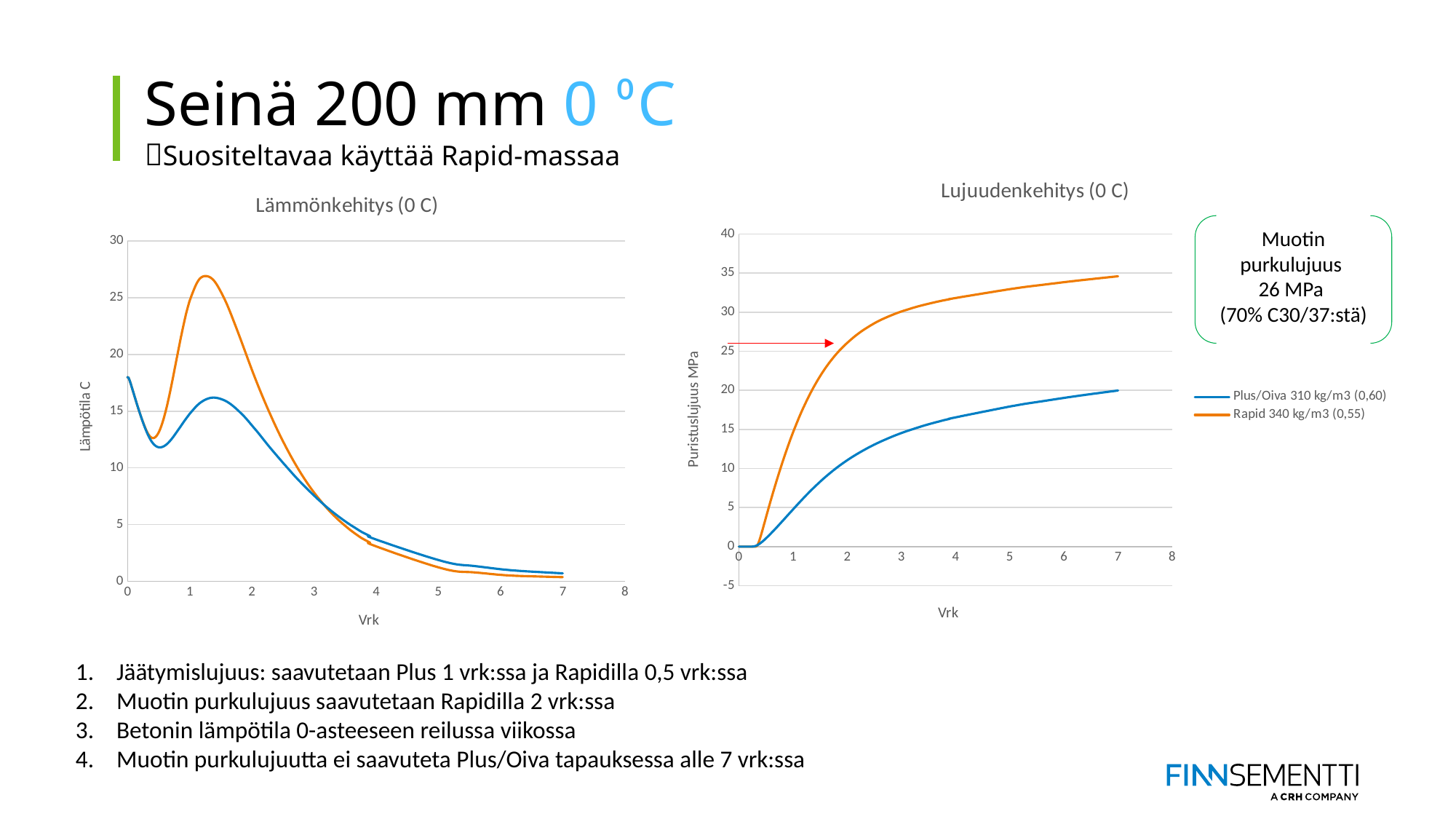
In the "Lujuudenkehitys (0 C)" chart, is the value of the Rapid 340 kg/m3 (0,55) series at 7 vrk greater or less than 30? greater What is the y-axis label of the "Lujuudenkehitys (0 C)" chart? Puristuslujuus MPa In the "Lujuudenkehitys (0 C)" chart, which series has the higher value at 7 vrk? Rapid 340 kg/m3 (0,55) In the "Lämmönkehitys (0 C)" chart, which series reaches the higher peak temperature? Rapid 340 kg/m3 (0,55) What kind of chart is the "Lämmönkehitys (0 C)" chart? line chart In the "Lämmönkehitys (0 C)" chart, is the peak value of the Plus/Oiva 310 kg/m3 (0,60) series greater or less than 20? less In the "Lujuudenkehitys (0 C)" chart, do the values rise or fall along the x axis? rise What kind of chart is the "Lujuudenkehitys (0 C)" chart? line chart In the "Lujuudenkehitys (0 C)" chart, is the value of the Plus/Oiva 310 kg/m3 (0,60) series at 3 vrk greater or less than 20? less How many series does the legend list for the charts on the slide? 2 In the "Lämmönkehitys (0 C)" chart, at 1 vrk, which series has the higher temperature? Rapid 340 kg/m3 (0,55)